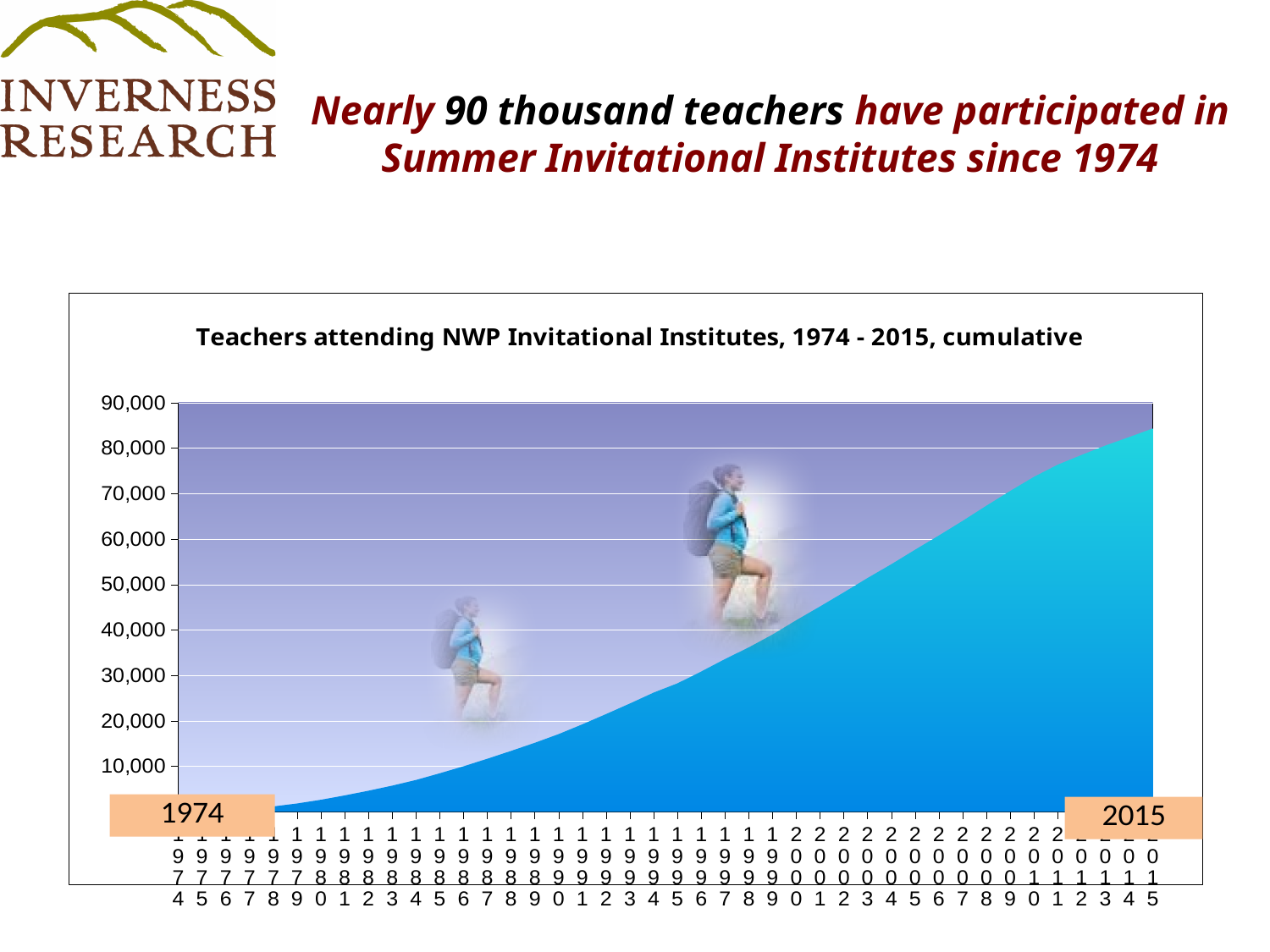
Is the value for 2015 greater or less than 80,000? greater Is the value for 2005 greater or less than 50,000? greater What kind of chart is shown on the slide? area chart Is the value for 2010 greater or less than 60,000? greater Which year has the lowest cumulative value? 1974 Which year has the highest cumulative value? 2015 What is the title of the chart? Teachers attending NWP Invitational Institutes, 1974 - 2015, cumulative Do the values rise or fall from 1974 to 2015? rise Which is larger, the value for 2000 or the value for 1990? 2000 How many years are plotted along the x axis? 42